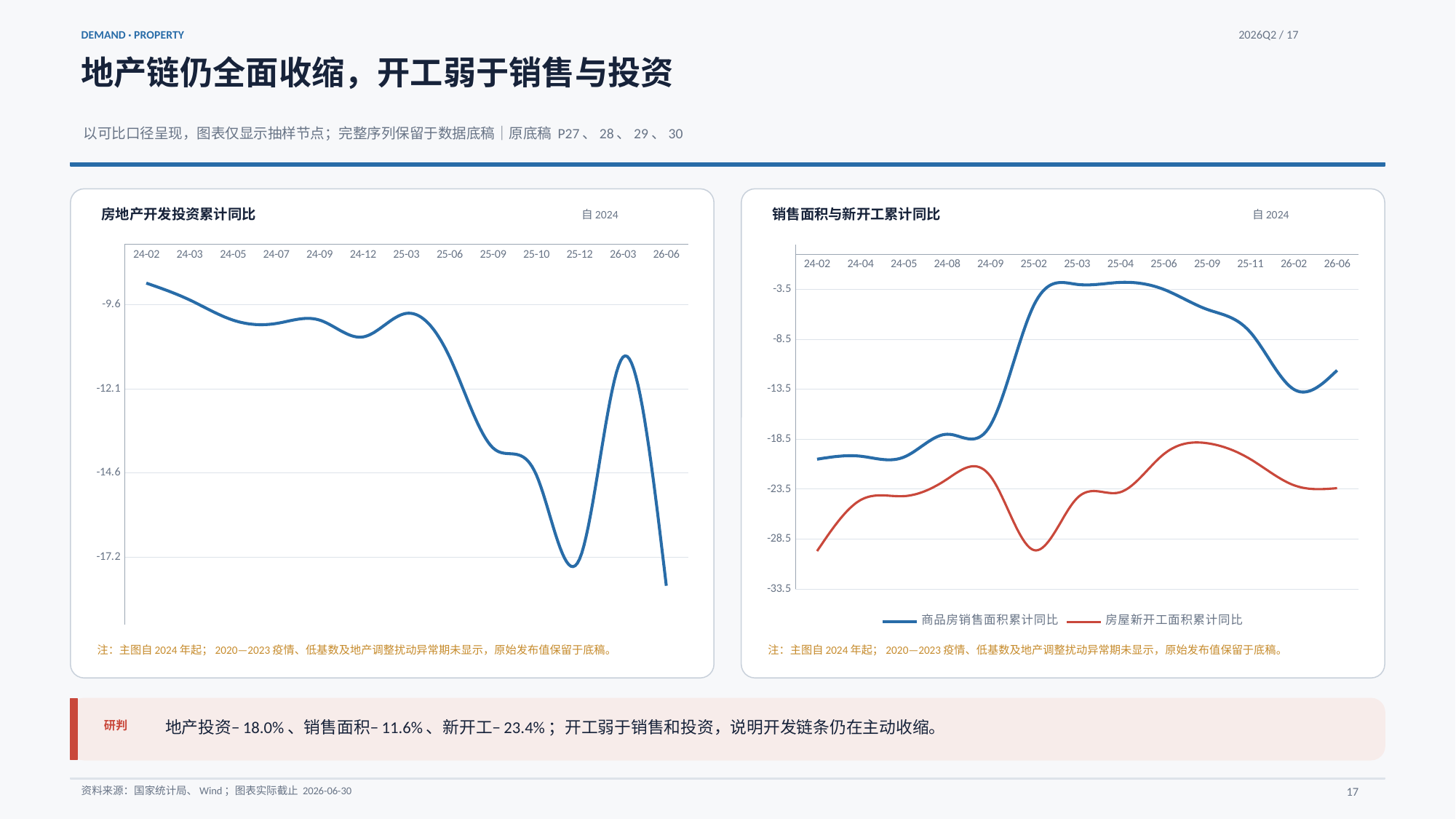
In the left chart (房地产开发投资累计同比), does the line overall rise or fall from 24-02 to 26-06? fall In the left chart (房地产开发投资累计同比), at which x-axis point is the line highest? 24-02 In the left chart (房地产开发投资累计同比), is the value at 26-06 greater or less than -17.2? less In the left chart (房地产开发投资累计同比), is the value at 26-03 greater or less than -12.1? greater What kind of chart is the left chart titled 房地产开发投资累计同比? line chart How many series does the legend of the right chart (销售面积与新开工累计同比) list? 2 In the right chart (销售面积与新开工累计同比), what colour is the 房屋新开工面积累计同比 line? red In the right chart (销售面积与新开工累计同比), is the 房屋新开工面积累计同比 value at 25-02 greater or less than -28.5? less In the right chart (销售面积与新开工累计同比), at 26-06 which series is higher, 商品房销售面积累计同比 or 房屋新开工面积累计同比? 商品房销售面积累计同比 How many x-axis time points are labelled on the left chart (房地产开发投资累计同比)? 13